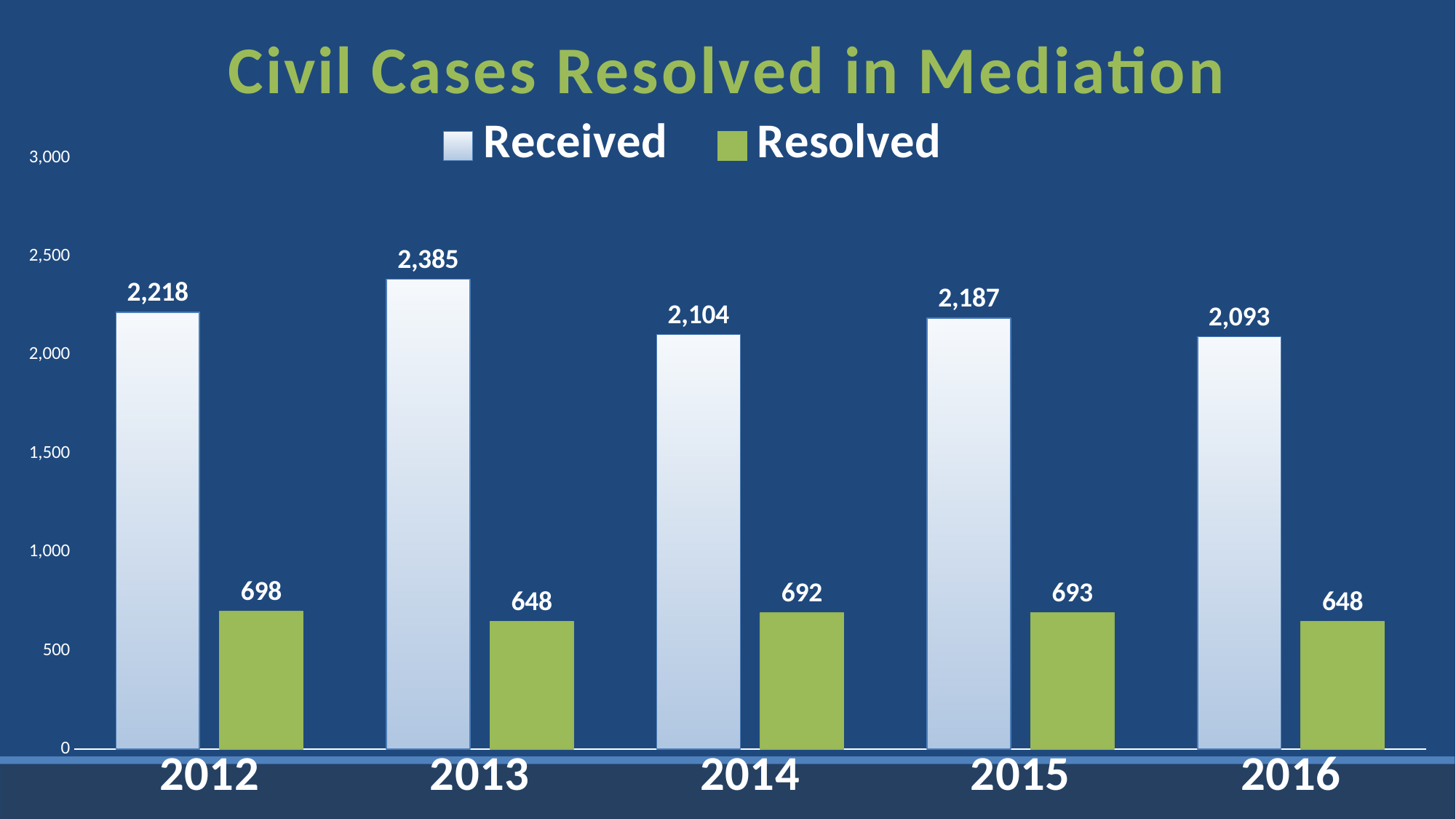
Which year had the highest number of cases received? 2013 What is the title of the chart? Civil Cases Resolved in Mediation How many series does the legend list? 2 What kind of chart is shown on the slide? bar chart Which year had the highest number of cases resolved? 2012 How many years are shown on the x axis? 5 Which year had the lowest number of cases received? 2016 Were more cases received in 2014 or in 2015? 2015 What is the difference between cases received and cases resolved in 2012? 1,520 How many civil cases were received in 2013? 2,385 How many civil cases were resolved in 2014? 692 Is the number of cases resolved in 2016 greater or less than 1,000? less